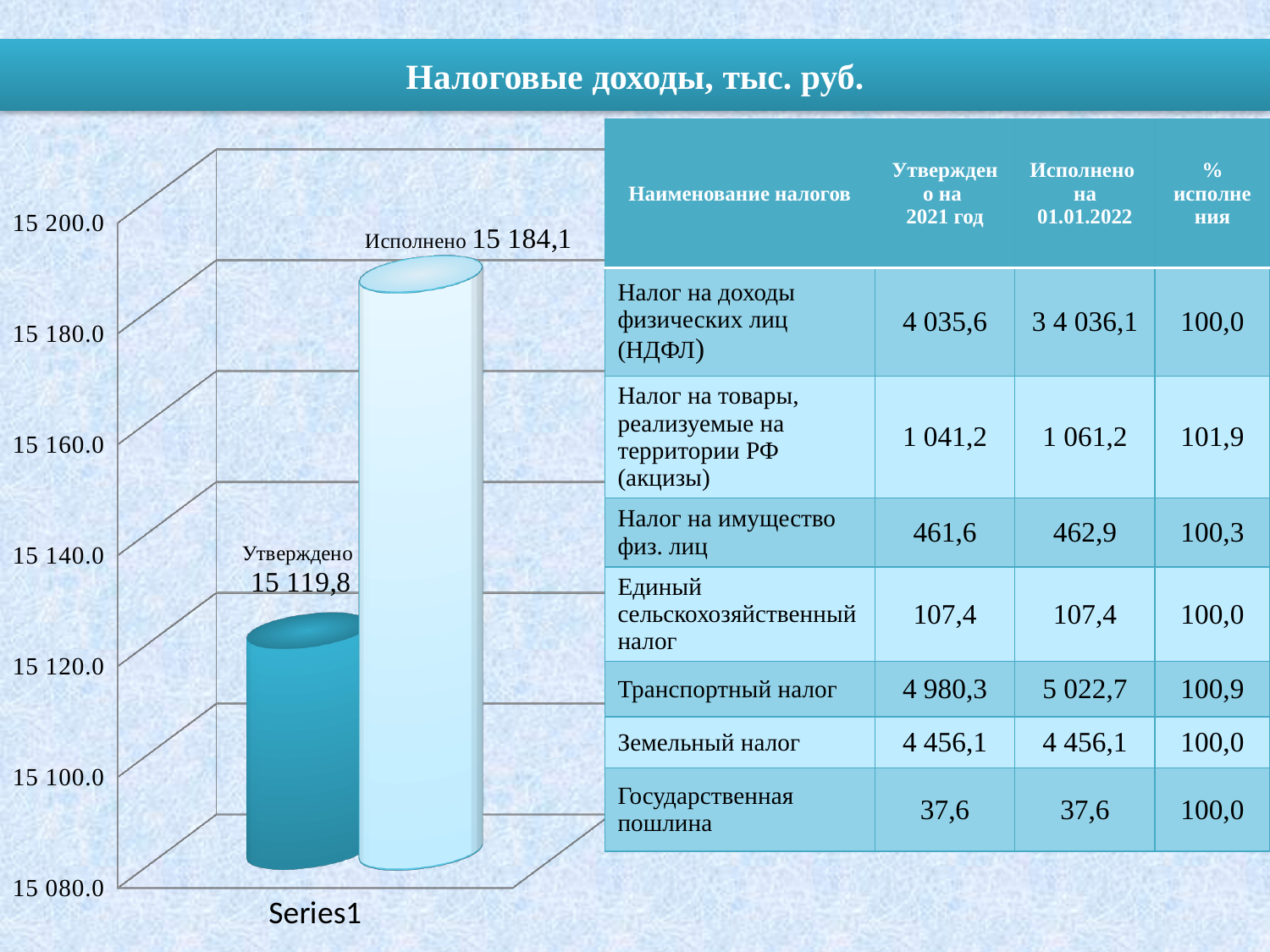
What is the title of the slide above the chart? Налоговые доходы, тыс. руб. Which bar is taller, Утверждено or Исполнено? Исполнено What is the difference between the Исполнено and Утверждено values? 64,3 Is the value for Исполнено greater or less than 15 160.0? greater What kind of chart is shown on the slide? bar chart What is the value of the Исполнено bar? 15 184,1 How many bars are plotted in the chart? 2 Which bar has the lowest value? Утверждено Is the value for Утверждено greater or less than 15 140.0? less What is the value of the Утверждено bar? 15 119,8 Which bar has the highest value? Исполнено What is the category label shown on the x axis of the chart? Series1